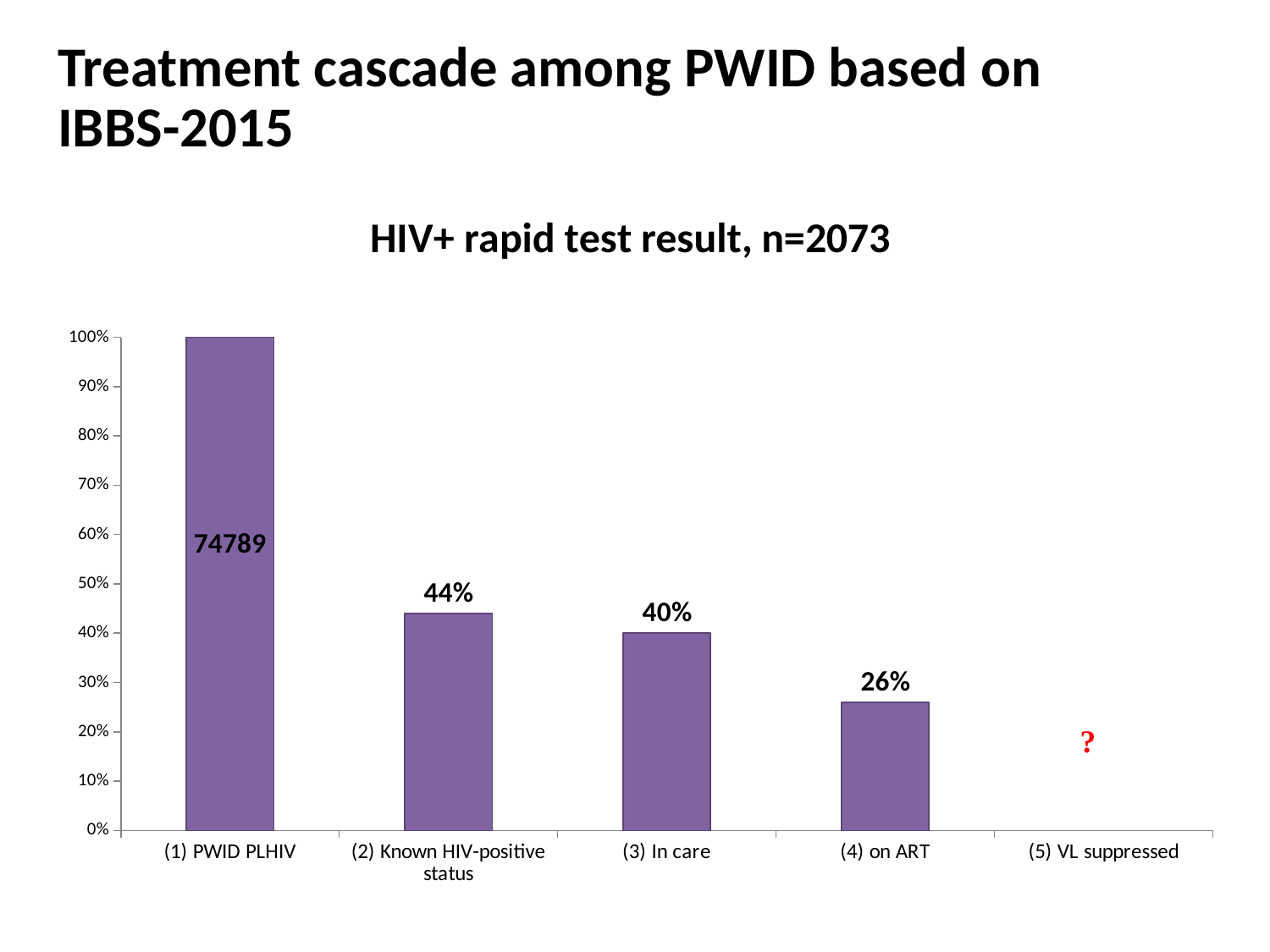
How many categories are listed on the x axis? 5 What is the value shown for (3) In care? 40% Which is larger, the value for (3) In care or the value for (4) on ART? (3) In care What is the value shown for (2) Known HIV-positive status? 44% Among the four categories with a plotted bar, which has the lowest value? (4) on ART What symbol is shown in place of a value for (5) VL suppressed? ? What is the value shown for (4) on ART? 26% What kind of chart is shown on the slide? bar chart What number is printed on the bar for (1) PWID PLHIV? 74789 Is the value for (1) PWID PLHIV greater or less than 90%? greater Which category has the tallest bar? (1) PWID PLHIV What is the difference between the values for (2) Known HIV-positive status and (4) on ART? 18%